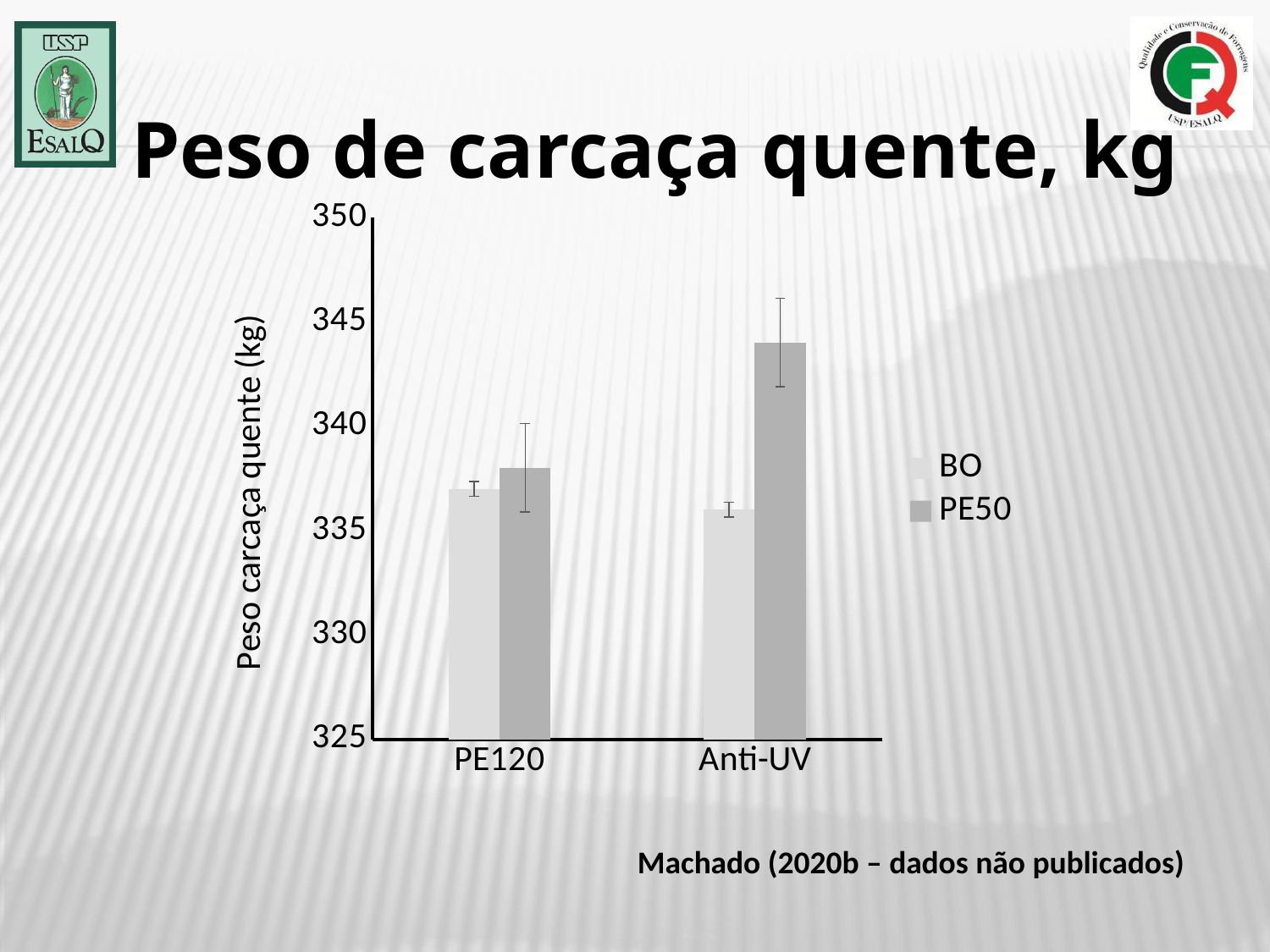
Is the BO value for Anti-UV greater or less than 335? greater How many series does the legend list? 2 Does the PE50 series rise or fall from PE120 to Anti-UV? rise Which bar is the highest in the chart? PE50 for Anti-UV Is the BO value for PE120 greater or less than 340? less Which series names are listed in the legend? BO and PE50 Is the PE50 value for PE120 greater or less than 340? less What is the title of the slide containing the chart? Peso de carcaça quente, kg For Anti-UV, which series has the larger value, BO or PE50? PE50 What kind of chart is shown on the slide? Bar chart How many categories are shown on the x axis of the chart? 2